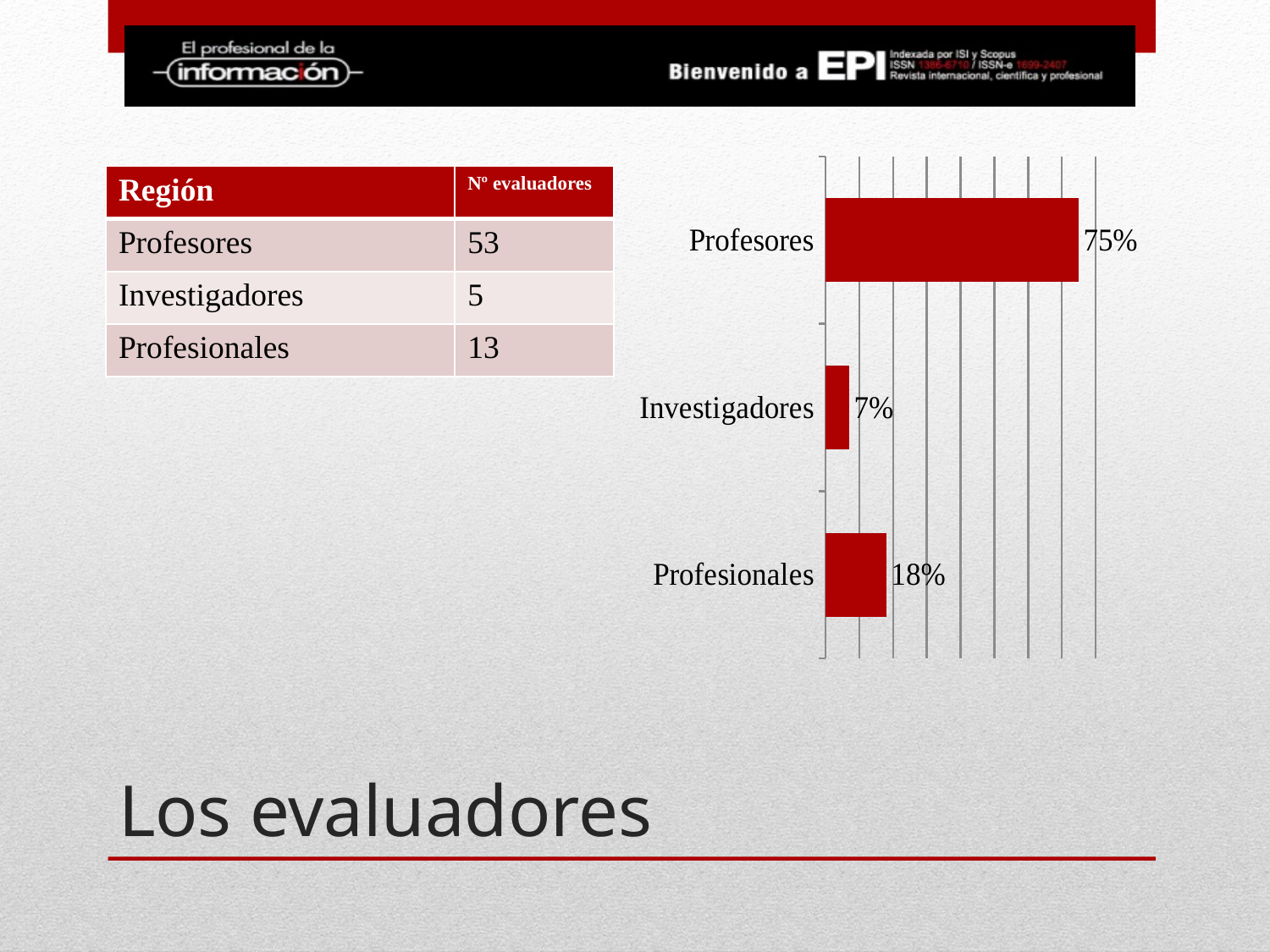
What is the difference between the values for Profesionales and Investigadores in the bar chart? 11% Which is larger in the bar chart, the value for Profesionales or the value for Investigadores? Profesionales Which category has the highest value in the bar chart? Profesores How many categories are shown in the bar chart? 3 Which category has the lowest value in the bar chart? Investigadores Are the bars in the chart horizontal or vertical? Horizontal What is the value for Profesionales in the bar chart? 18% What colour are the bars in the chart? Dark red What is the value for Investigadores in the bar chart? 7% What is the value for Profesores in the bar chart? 75% What kind of chart is shown on the slide? Bar chart What is the difference between the values for Profesores and Profesionales in the bar chart? 57%